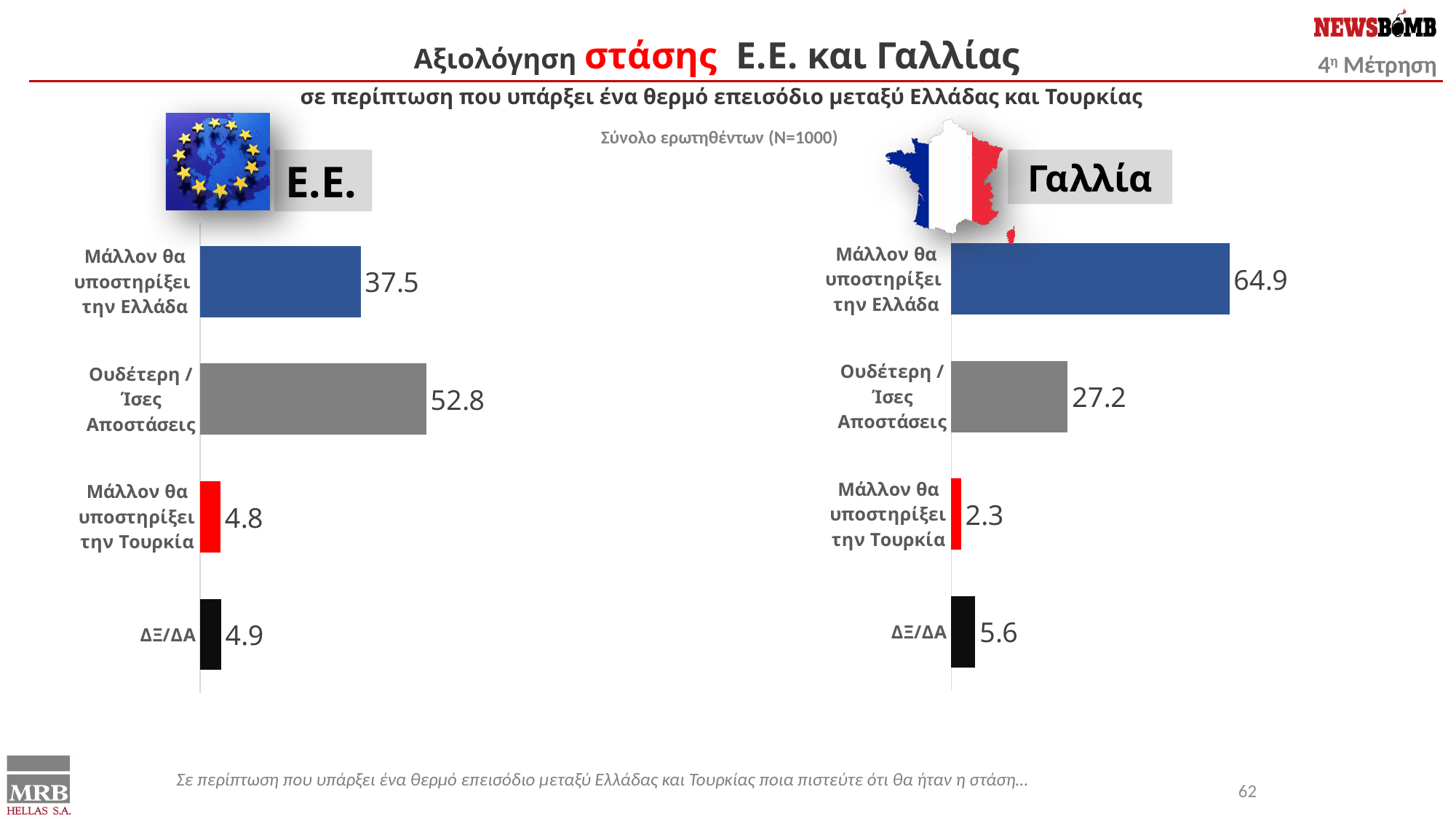
What is the difference between the 'Μάλλον θα υποστηρίξει την Ελλάδα' values in the Γαλλία chart and the Ε.Ε. chart? 27.4 In the Γαλλία chart, what is the value for 'Μάλλον θα υποστηρίξει την Ελλάδα'? 64.9 In the Γαλλία chart, which category has the lowest value? Μάλλον θα υποστηρίξει την Τουρκία How many categories does the Γαλλία chart show? 4 What colour is the 'Μάλλον θα υποστηρίξει την Τουρκία' bar in both charts? Red Which is larger: 'Μάλλον θα υποστηρίξει την Τουρκία' in the Ε.Ε. chart or in the Γαλλία chart? Ε.Ε. chart In the Ε.Ε. chart, what is the value for 'Μάλλον θα υποστηρίξει την Ελλάδα'? 37.5 In the Ε.Ε. chart, what is the value for 'Ουδέτερη / Ίσες Αποστάσεις'? 52.8 What type of chart is the Ε.Ε. chart? Bar chart In the Ε.Ε. chart, what is the difference between 'Ουδέτερη / Ίσες Αποστάσεις' and 'Μάλλον θα υποστηρίξει την Ελλάδα'? 15.3 In the Ε.Ε. chart, which category has the highest value? Ουδέτερη / Ίσες Αποστάσεις In the Γαλλία chart, what is the value for 'ΔΞ/ΔΑ'? 5.6